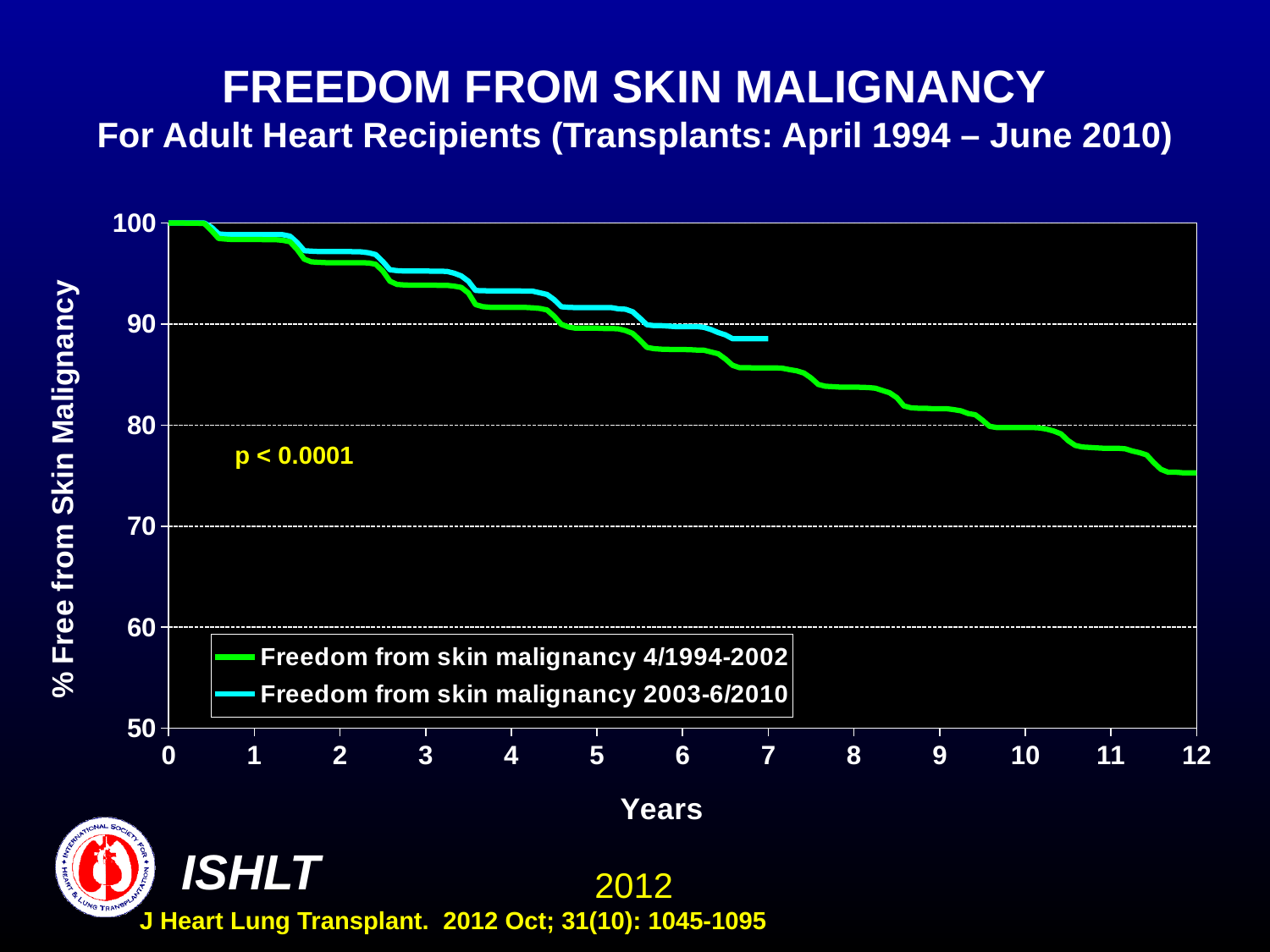
What kind of chart is shown on the slide? line chart Is the value for the 4/1994-2002 cohort at year 8 greater or less than 80? greater Is the value for the 2003-6/2010 cohort at year 3 greater or less than 90? greater At year 5, which cohort has the higher % free from skin malignancy, 4/1994-2002 or 2003-6/2010? 2003-6/2010 How many series does the legend list? 2 Does the freedom from skin malignancy for the 2003-6/2010 cohort rise or fall over the years shown? fall Which colour represents the 2003-6/2010 cohort in the legend? cyan (light blue) Is the value for the 4/1994-2002 cohort at year 12 greater or less than 80? less What p-value is printed on the chart? p < 0.0001 Does the freedom from skin malignancy for the 4/1994-2002 cohort rise or fall as years since transplant increase? fall